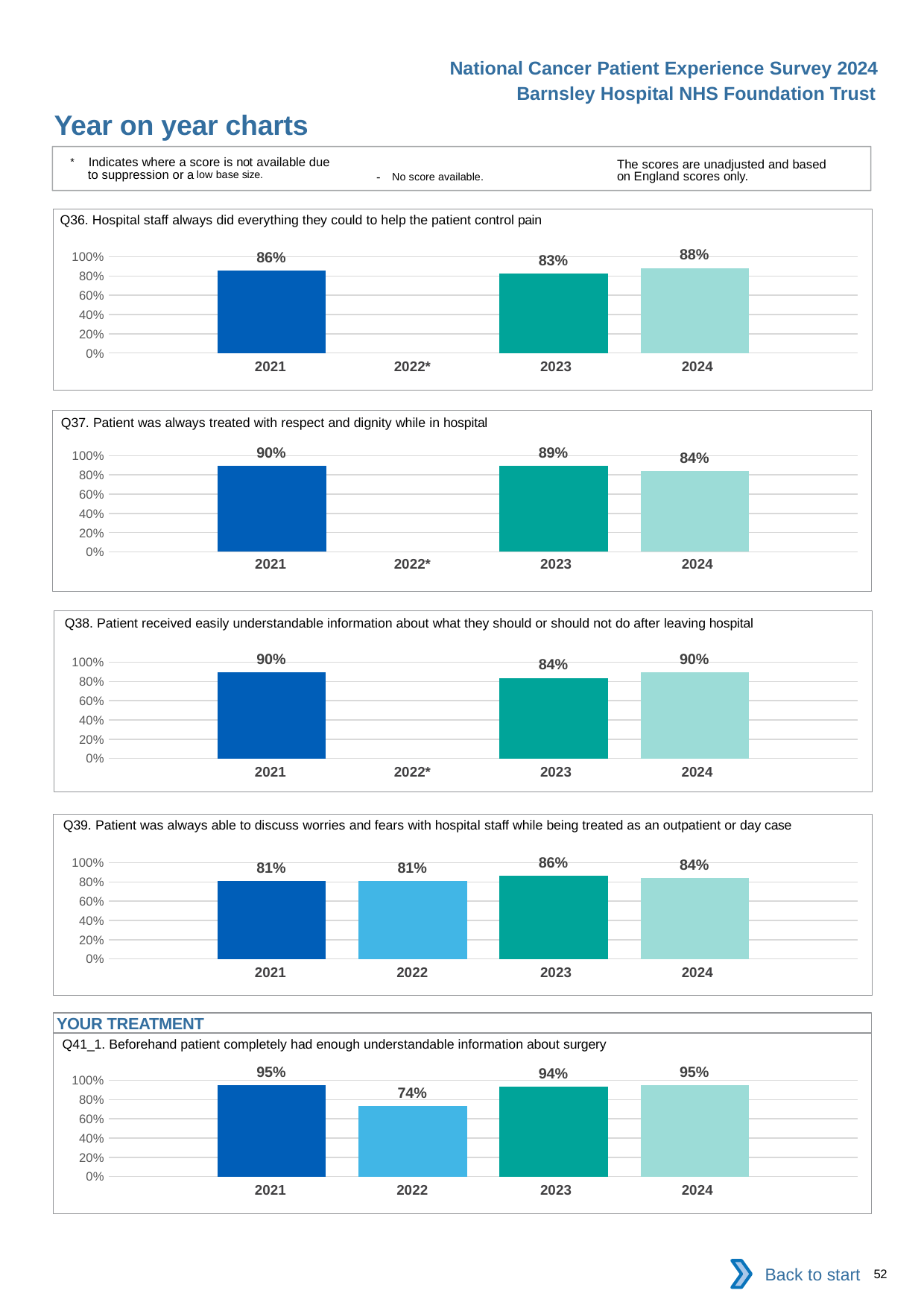
In the Q36 chart (hospital staff helped control pain), what is the value for 2024? 88% In the Q38 chart (understandable information after leaving hospital), which year has the lowest value? 2023 In the Q39 chart (discuss worries and fears as an outpatient), what is the value for 2022? 81% In the Q37 chart (treated with respect and dignity), what is the difference between the 2023 and 2024 values? 5% In the Q36 chart (hospital staff helped control pain), which year has the lowest plotted value? 2023 In the Q39 chart (discuss worries and fears as an outpatient), which year has the highest value? 2023 In the Q38 chart (understandable information after leaving hospital), how many years have a bar plotted? 3 In the Q41_1 chart (information about surgery), what is the value for 2022? 74% In the Q41_1 chart (information about surgery), what is the difference between the 2021 and 2022 values? 21% What type of chart is used for Q36? Bar chart In the Q37 chart (treated with respect and dignity), what is the value for 2021? 90% In the Q41_1 chart (information about surgery), which is larger, the 2022 value or the 2023 value? 2023